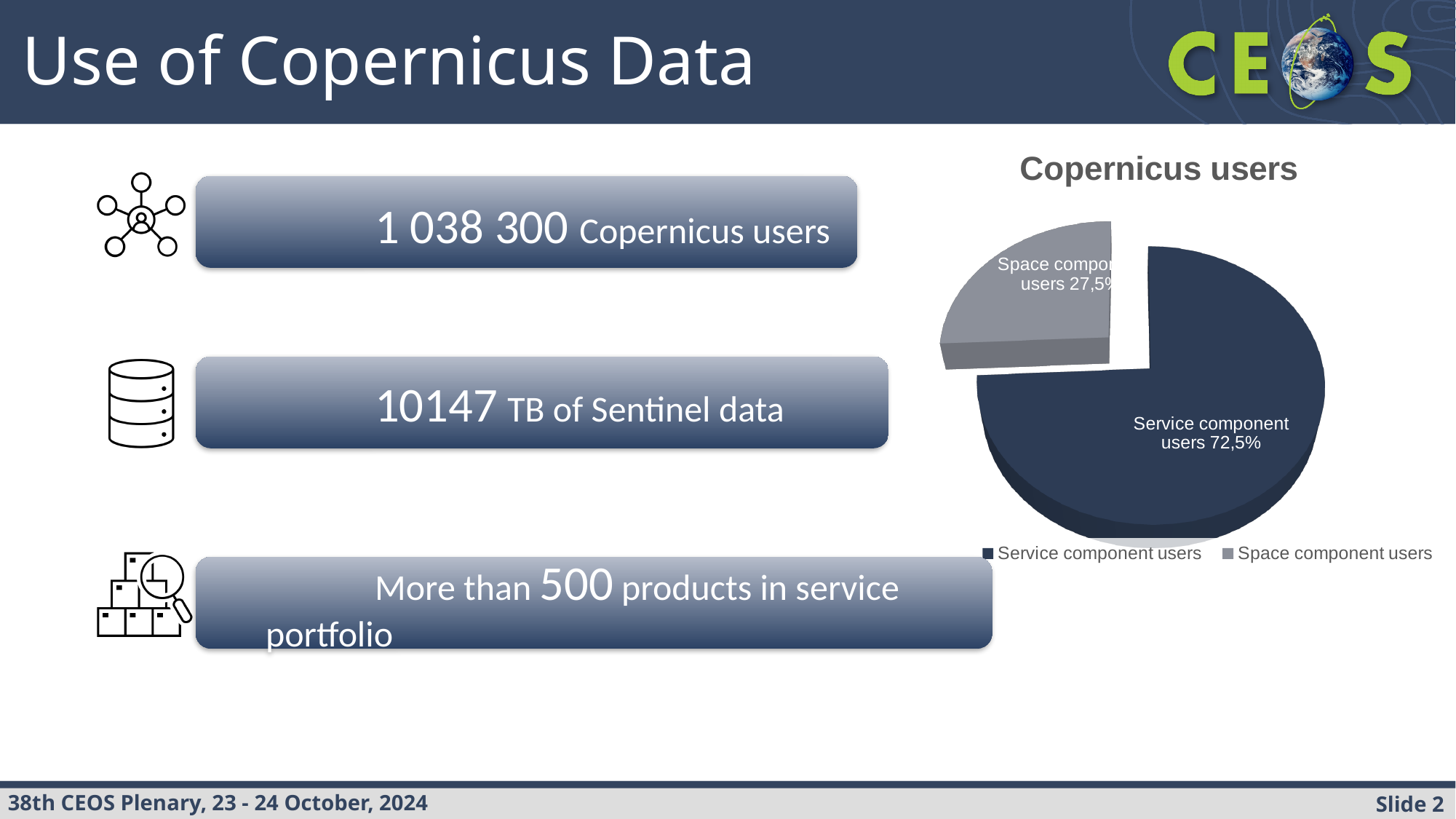
What share of the pie is Space component users? 27,5% What is the difference in percentage points between Service component users and Space component users? 45 percentage points What is the title of the chart? Copernicus users How many slices does the pie chart have? 2 Which slice is shown in grey? Space component users What kind of chart is shown on the slide? pie chart What share of the pie is Service component users? 72,5% Which slice of the pie is the largest? Service component users How many entries does the chart legend list? 2 Which slice of the pie is the smallest? Space component users Which is larger, the Service component users slice or the Space component users slice? Service component users